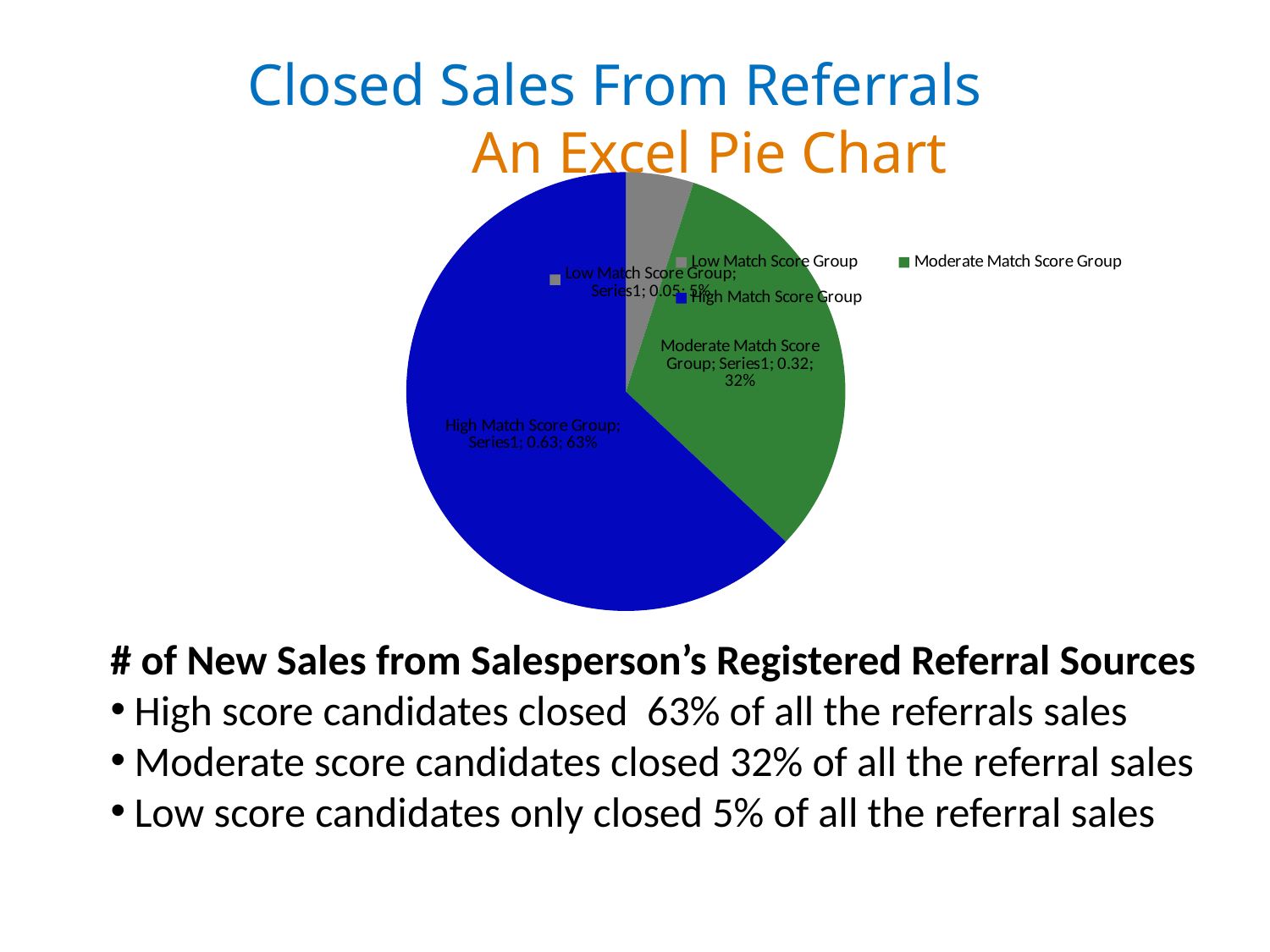
What colour is the High Match Score Group slice? blue What is the difference in percentage points between the High Match Score Group and the Moderate Match Score Group slices? 31% What percentage of the pie does the High Match Score Group slice represent? 63% What percentage of the pie does the Moderate Match Score Group slice represent? 32% Which group has the smallest slice of the pie? Low Match Score Group Which slice is larger, Moderate Match Score Group or Low Match Score Group? Moderate Match Score Group What percentage of the pie does the Low Match Score Group slice represent? 5% What is the data value shown for the Moderate Match Score Group slice? 0.32 What colour is the Low Match Score Group slice? gray What kind of chart is shown on the slide? pie chart How many slices does the pie chart have? 3 Which group has the largest slice of the pie? High Match Score Group